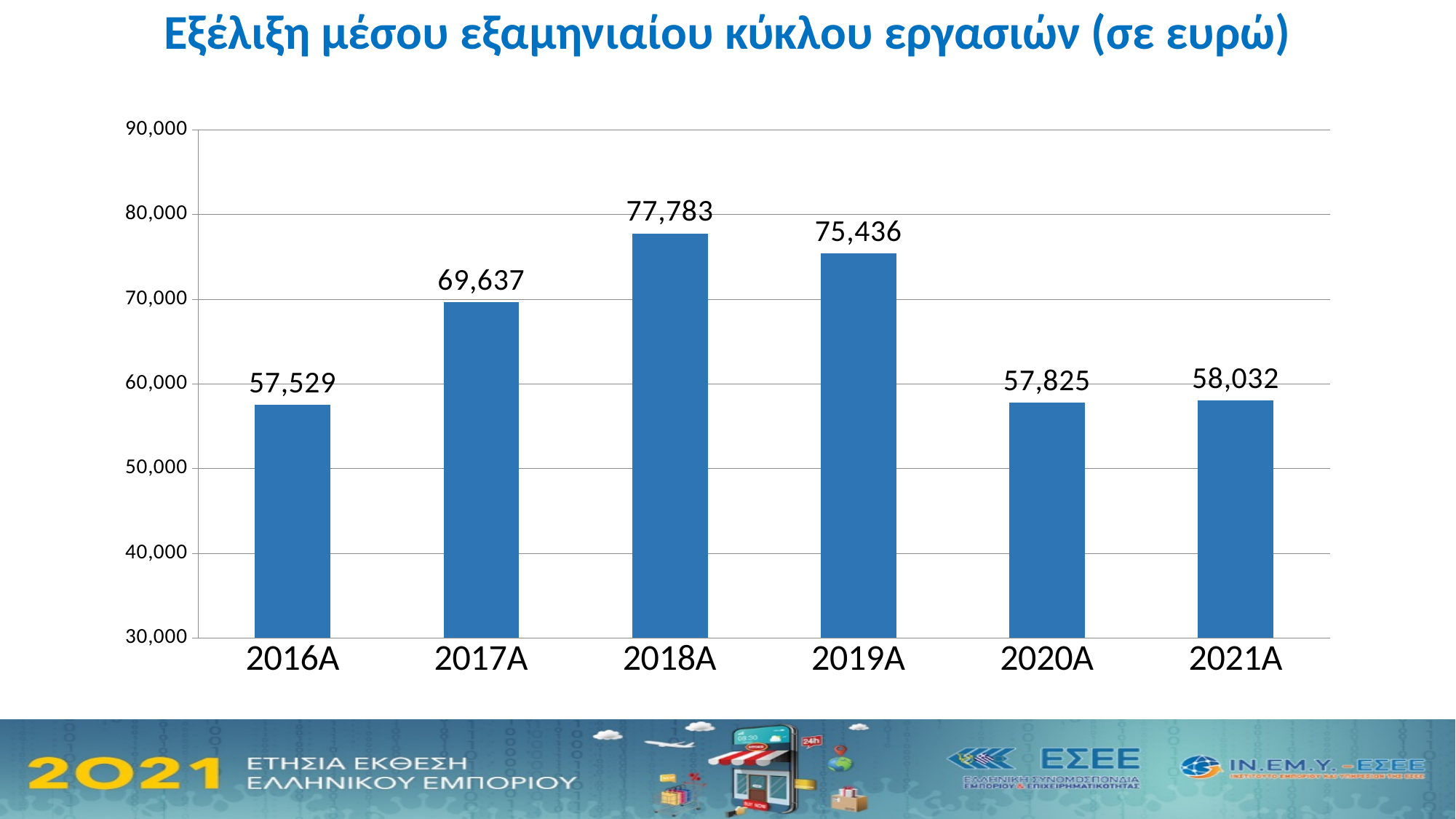
What kind of chart is shown on the slide? bar chart What is the value for 2017A? 69,637 Which year has the lowest value? 2016A How many years are shown on the x axis? 6 Which is larger, the value for 2017A or the value for 2019A? 2019A What is the difference between the values for 2021A and 2020A? 207 What is the value for 2020A? 57,825 Is the value for 2016A greater or less than 60,000? less Which year has the highest value? 2018A What is the difference between the values for 2018A and 2019A? 2,347 Do the values rise or fall from 2018A to 2020A? fall What is the value for 2018A? 77,783